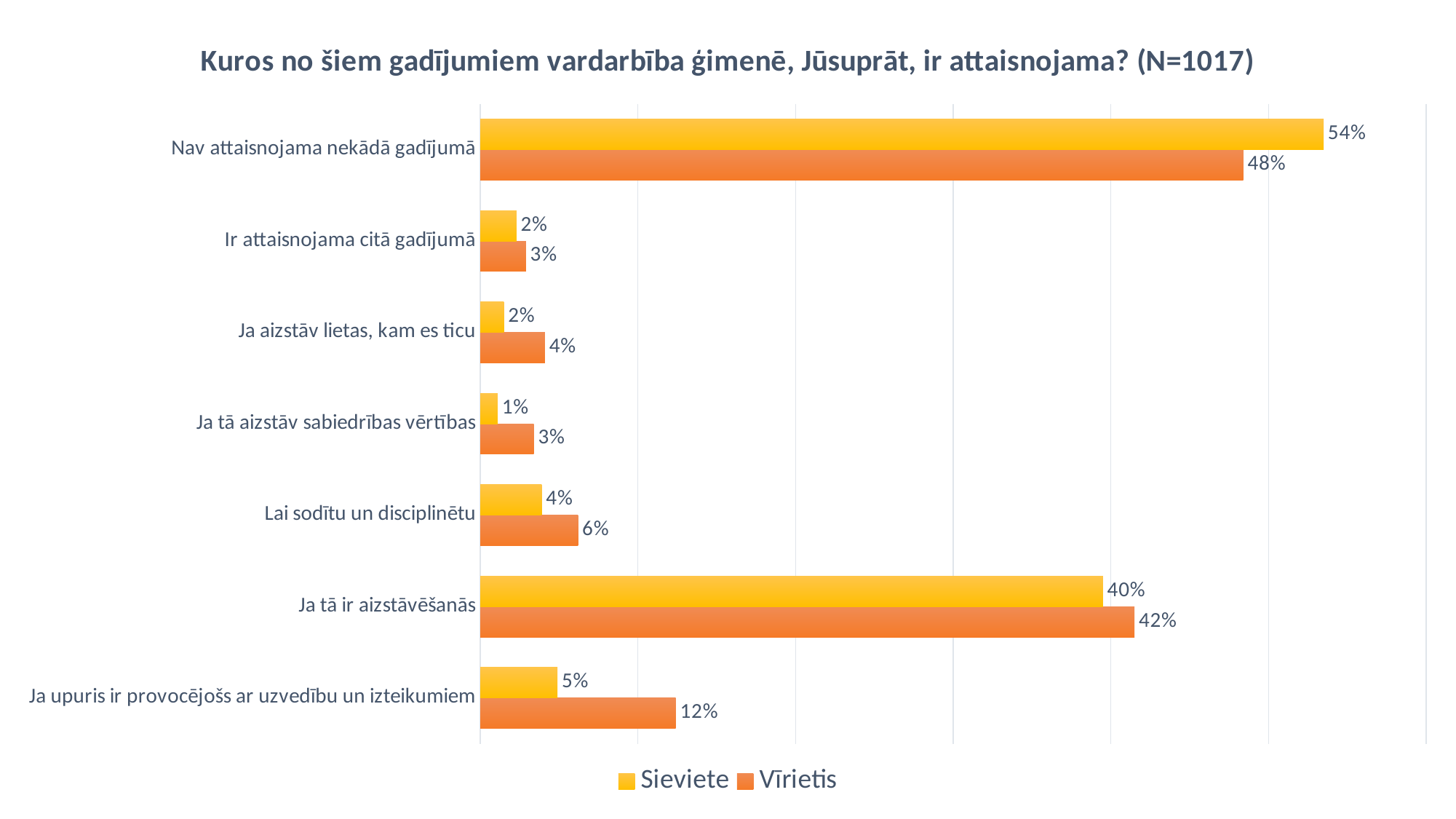
How many series does the legend list? 2 What is the value for Vīrietis for "Ja upuris ir provocējošs ar uzvedību un izteikumiem"? 12% How many categories are shown on the chart? 7 What is the difference between the Sieviete and Vīrietis values for "Nav attaisnojama nekādā gadījumā"? 6% What is the value for Sieviete for "Lai sodītu un disciplinētu"? 4% Which category has the lowest value for Sieviete? Ja tā aizstāv sabiedrības vērtības For "Ja tā ir aizstāvēšanās", which is larger: the Sieviete value or the Vīrietis value? Vīrietis Which category has the highest value for Vīrietis? Nav attaisnojama nekādā gadījumā What is the difference between the Vīrietis and Sieviete values for "Ja upuris ir provocējošs ar uzvedību un izteikumiem"? 7% What is the value for Sieviete for "Nav attaisnojama nekādā gadījumā"? 54% What is the value for Vīrietis for "Ja tā ir aizstāvēšanās"? 42% What kind of chart is shown on the slide? Bar chart